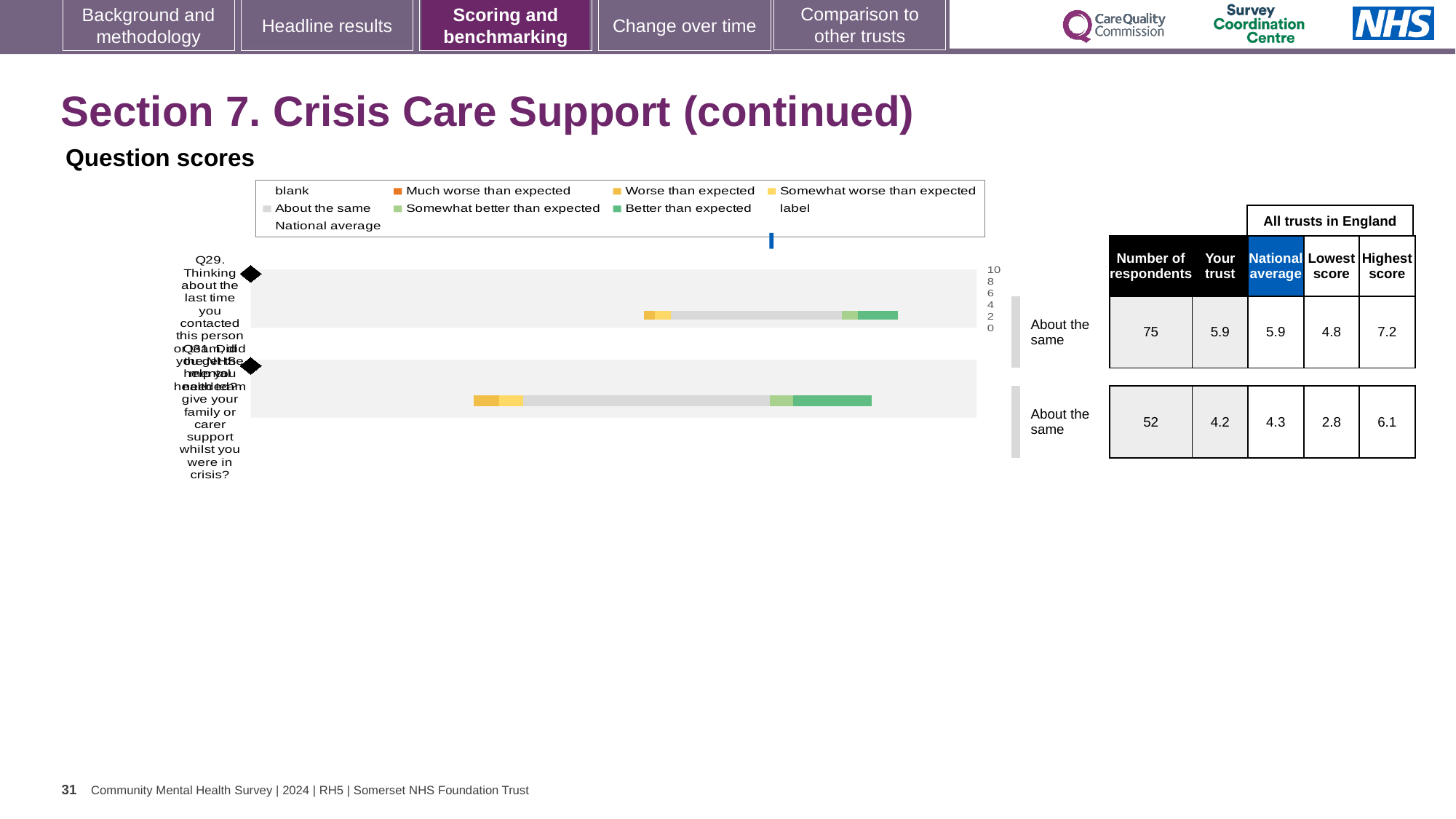
How many questions are plotted in the question scores chart? 2 In the chart legend, what colour represents 'Better than expected'? green What kind of chart is used to show the question scores on this slide? bar chart What is the national average score for Q31 in the table beside the chart? 4.3 Which question has more respondents in the table, Q29 or Q31? Q29 Is the 'Your trust' score higher for Q29 or for Q31? Q29 How many respondents answered Q29 according to the table? 75 What is the difference between the highest score and the lowest score for Q29 in the table? 2.4 According to the table beside the chart, what is the 'Your trust' score for Q31? 4.2 What is the maximum value shown on the chart's score axis? 10 What is the difference between the highest score and the lowest score for Q31 in the table? 3.3 According to the table beside the chart, what is the 'Your trust' score for Q29? 5.9